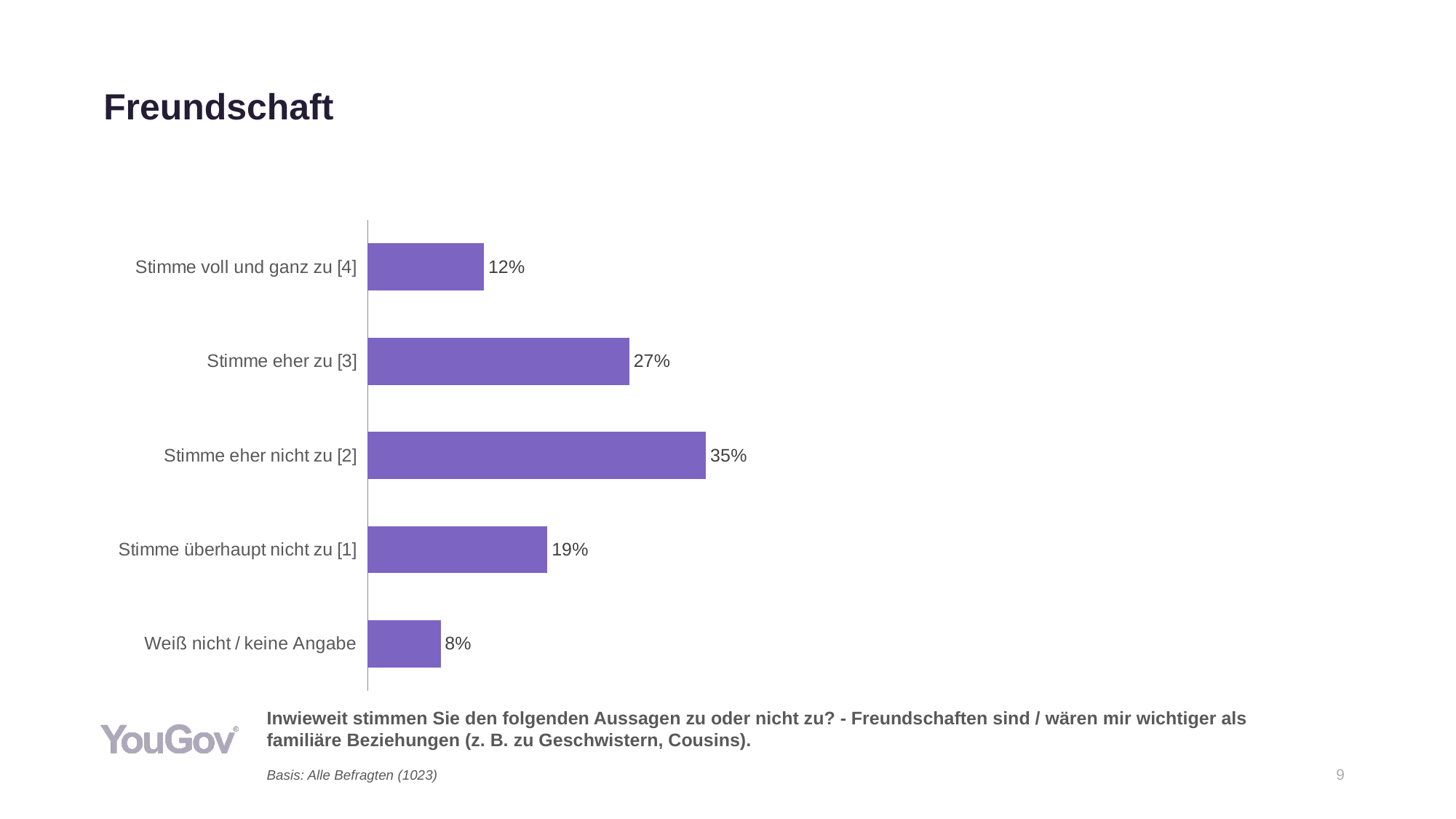
What percentage of respondents answered "Stimme voll und ganz zu [4]"? 12% What is the title of the slide? Freundschaft Which is larger: "Stimme überhaupt nicht zu [1]" or "Stimme voll und ganz zu [4]"? Stimme überhaupt nicht zu [1] How many categories are shown in the chart? 5 What is the difference between "Stimme eher zu [3]" and "Stimme voll und ganz zu [4]"? 15% What is the difference between "Stimme eher nicht zu [2]" and "Stimme überhaupt nicht zu [1]"? 16% What is the combined value of "Stimme voll und ganz zu [4]" and "Stimme eher zu [3]"? 39% Which category has the highest value? Stimme eher nicht zu [2] What is the value shown for "Stimme eher zu [3]"? 27% What is the value shown for "Weiß nicht / keine Angabe"? 8% Which category has the lowest value? Weiß nicht / keine Angabe What kind of chart is shown on the slide? Bar chart